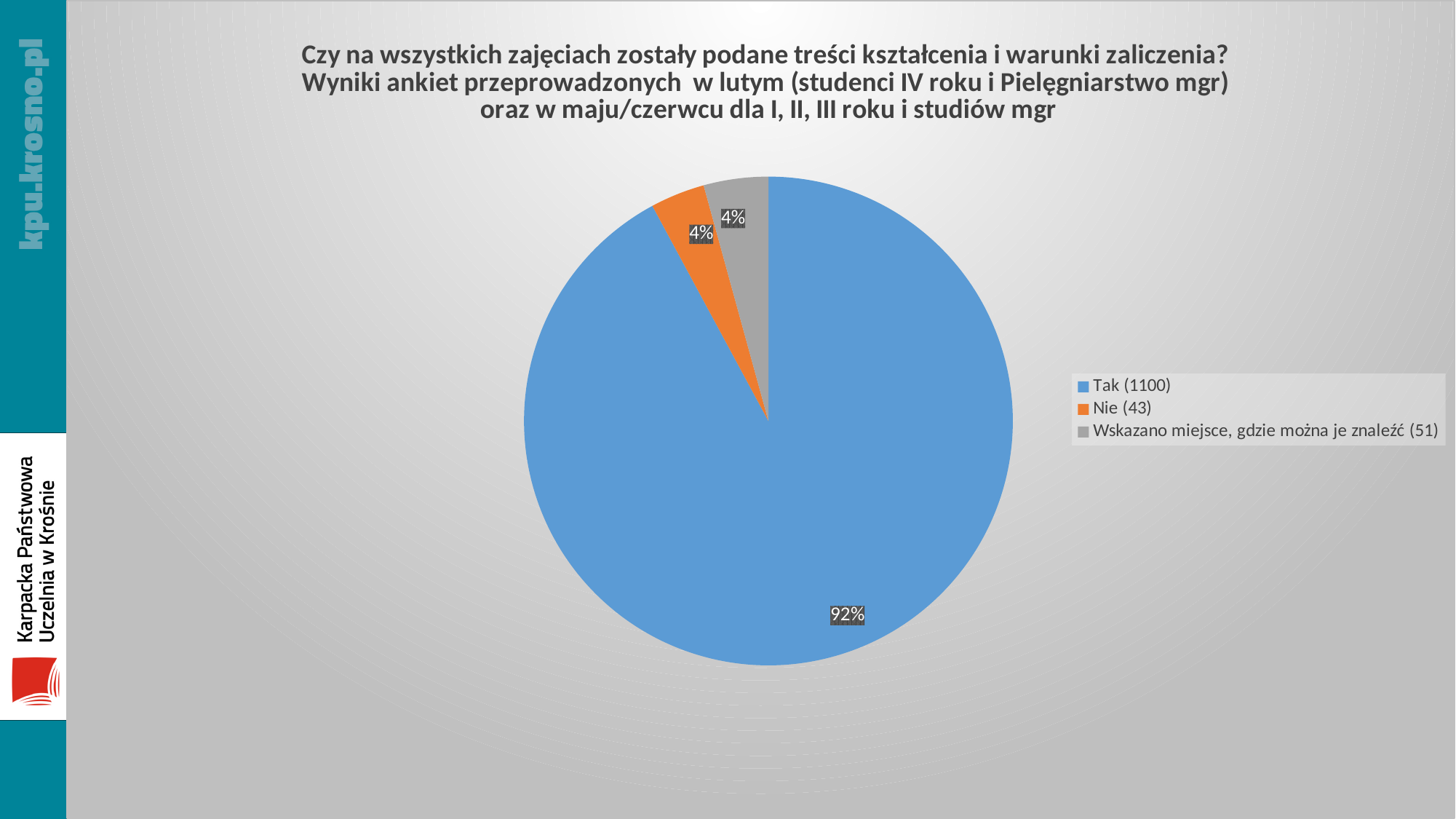
What type of chart is shown on the slide? pie chart How many responses does the legend give for "Nie"? 43 Which category has the largest share of the pie? Tak What percentage is shown for the "Wskazano miejsce, gdzie można je znaleźć" slice? 4% Based on the counts in the legend, which category has the fewest responses? Nie What is the difference between the number of "Tak" responses and the number of "Nie" responses? 1057 How many responses does the legend give for "Tak"? 1100 What percentage is shown for the "Nie" slice? 4% How many responses does the legend give for "Wskazano miejsce, gdzie można je znaleźć"? 51 What percentage of the pie does the "Tak" slice represent? 92% How many slices does the pie chart have? 3 Which colour is used for the "Nie" slice? orange